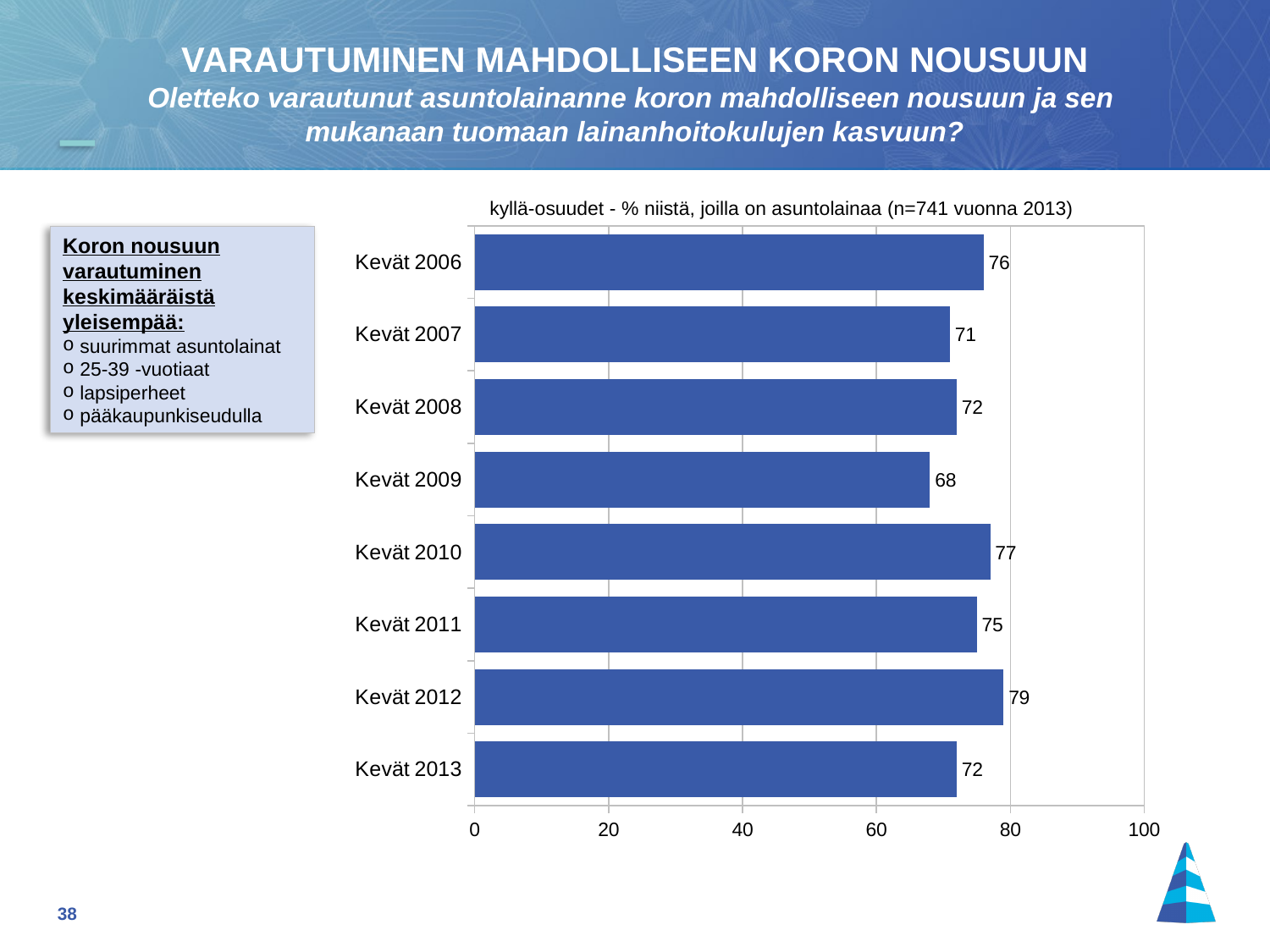
Is the value for Kevät 2007 greater or less than 60? greater Which is larger, the value for Kevät 2010 or the value for Kevät 2011? Kevät 2010 Which category has the highest value? Kevät 2012 What is the value for Kevät 2013? 72 What is the chart's title? kyllä-osuudet - % niistä, joilla on asuntolainaa (n=741 vuonna 2013) What is the difference between the values for Kevät 2012 and Kevät 2009? 11 How many categories are shown in the chart? 8 What kind of chart is shown on the slide? bar chart What is the value for Kevät 2006? 76 What is the difference between the values for Kevät 2006 and Kevät 2007? 5 What is the value for Kevät 2009? 68 Which category has the lowest value? Kevät 2009